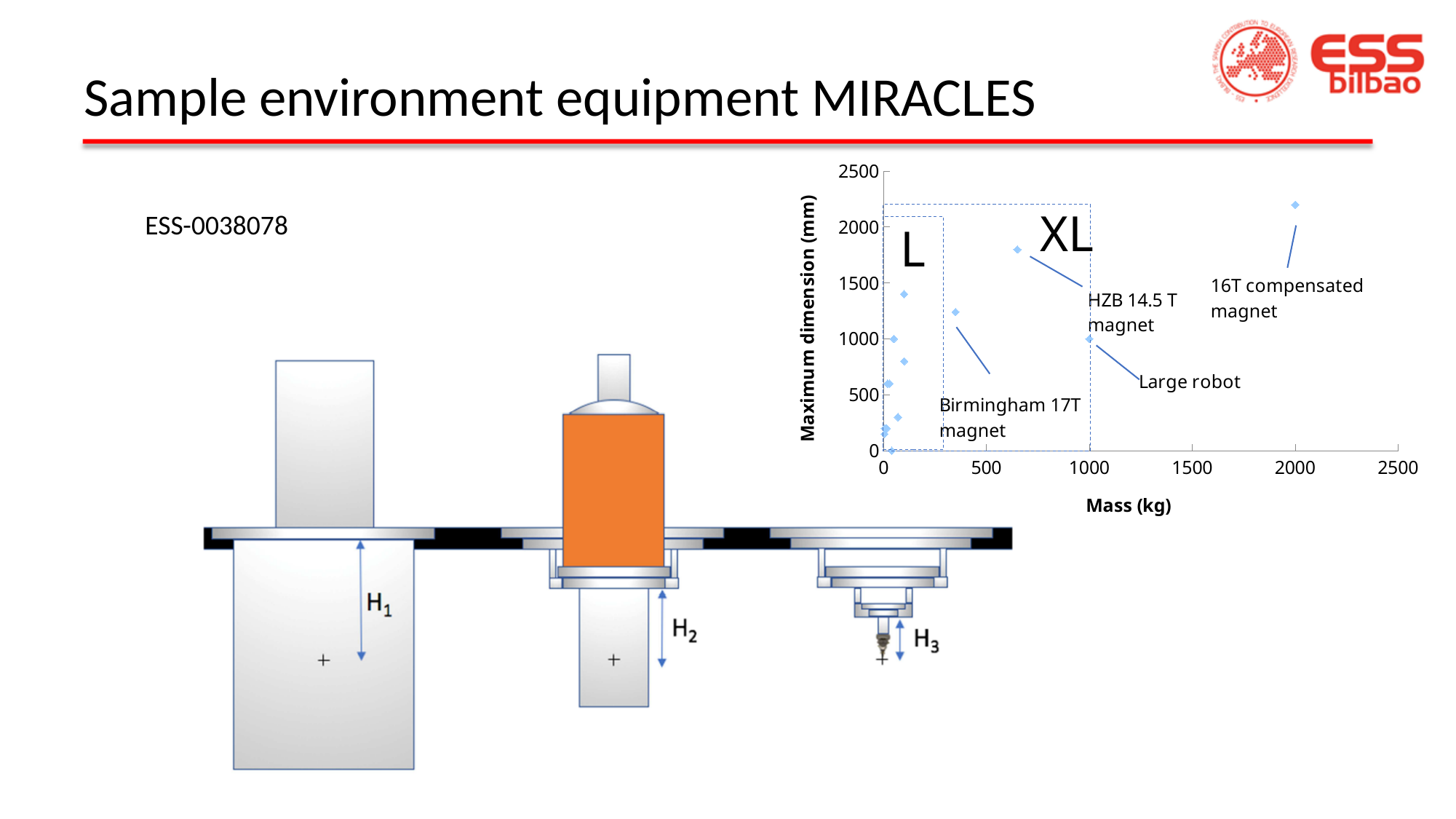
Which labeled item has the largest maximum dimension? 16T compensated magnet Is the maximum dimension of the Birmingham 17T magnet greater or less than 1000? greater Which has the larger maximum dimension, the HZB 14.5 T magnet or the Large robot? HZB 14.5 T magnet Is the maximum dimension of the HZB 14.5 T magnet greater or less than 1500? greater Is the mass of the Birmingham 17T magnet greater or less than 500? less What kind of chart is shown on the slide? scatter chart Which labeled item has the highest mass? 16T compensated magnet What is the title of the x axis of the chart? Mass (kg) What is the title of the y axis of the chart? Maximum dimension (mm) Which has the greater mass, the Birmingham 17T magnet or the Large robot? Large robot